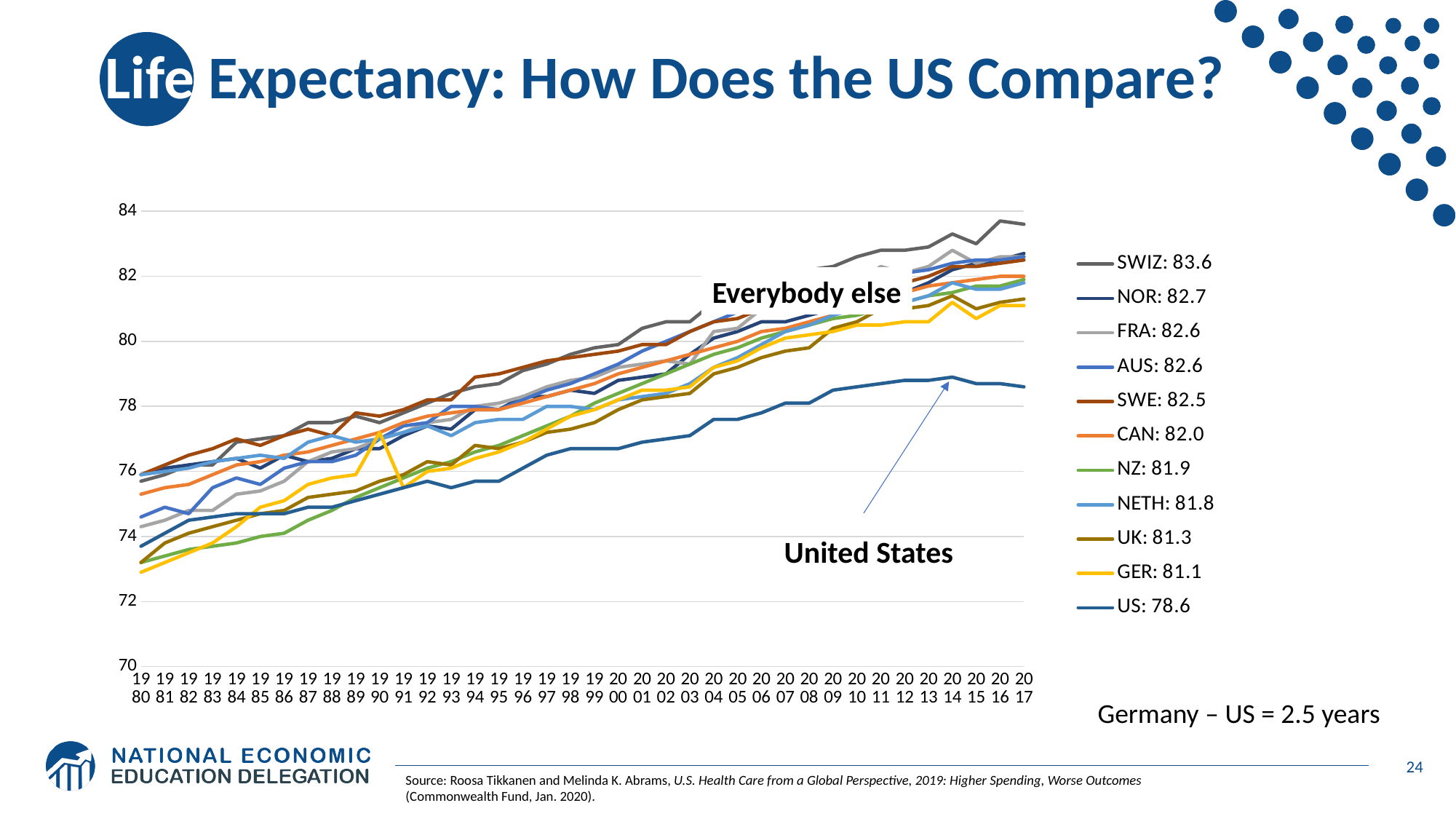
What kind of chart is shown on the slide? line chart What is the difference between the GER value and the US value shown in the legend? 2.5 Which country has the highest life expectancy value in the legend? SWIZ What life expectancy value is shown for US in the legend? 78.6 What is the difference between the SWIZ value and the US value shown in the legend? 5.0 How many series does the legend list? 11 Which country has the lowest life expectancy value in the legend? US What is the first year shown on the x axis? 1980 Is the value for the US line in 2017 greater or less than 80? less Which has a higher value in the legend, NOR or CAN? NOR Does the US line rise or fall from 1980 to 2017? rise What life expectancy value is shown for SWIZ in the legend? 83.6